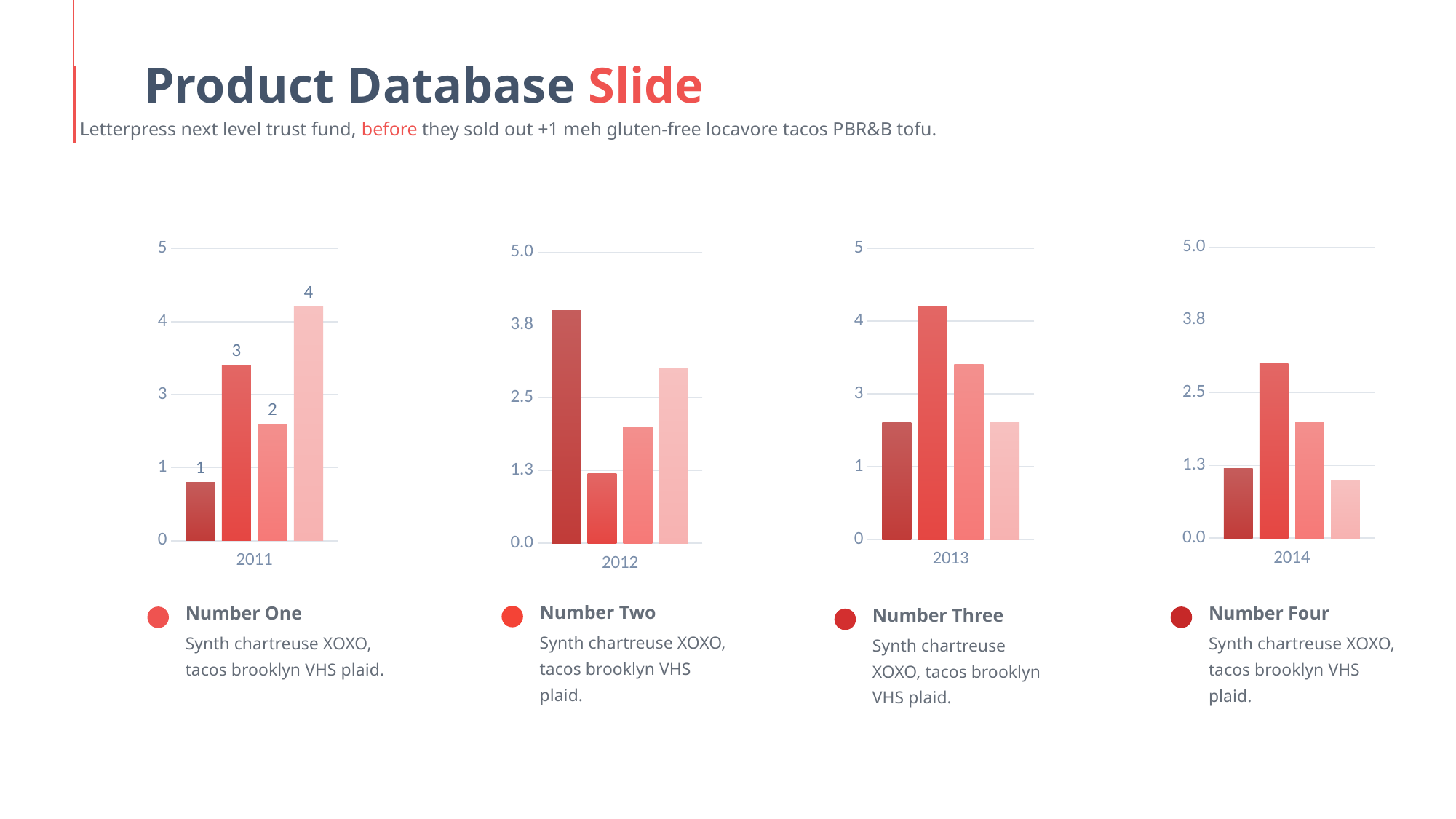
In the 2012 chart, is the value of the first (leftmost) bar greater or less than 2.5? greater In the 2012 chart, is the value of the second bar greater or less than 2.5? less In the 2011 chart, which bar has the lowest value? the first (leftmost) bar In the 2011 chart, what is the value labelled on the first (leftmost) bar? 1 In the 2011 chart, what is the value labelled on the fourth (rightmost) bar? 4 How many bars are plotted in the 2011 chart? 4 In the 2011 chart, what is the difference between the highest labelled value and the lowest labelled value? 3 What kind of chart is the leftmost chart (2011)? bar chart In the 2013 chart, which is larger: the first bar or the third bar? the third bar In the 2013 chart, which bar is the tallest? the second bar How many bar charts are shown on the slide? 4 In the 2011 chart, which bar has the highest value? the fourth (rightmost) bar